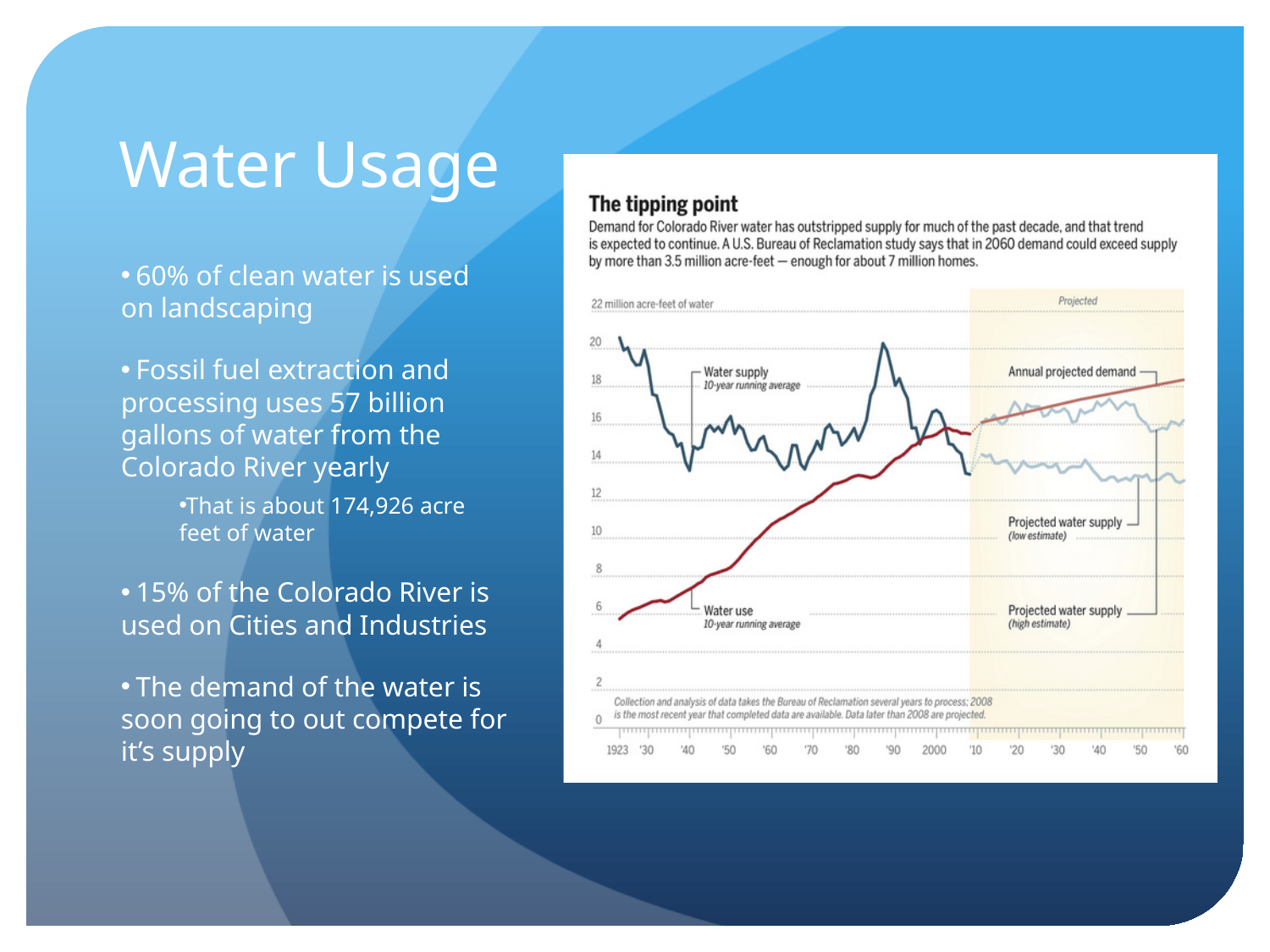
What is the title of the chart on the slide? The tipping point Does the Water use 10-year running average line rise or fall from 1923 to 2008? rise Is the Annual projected demand value in 2060 greater or less than 16 million acre-feet? greater In 2060, which is larger: the Annual projected demand or the Projected water supply (high estimate)? Annual projected demand What unit is the y axis of the chart measured in? million acre-feet of water What kind of chart is shown on the slide? line chart Is the Water use value in 1923 greater or less than 6 million acre-feet? less Is the Water use value around 2000 greater or less than 12 million acre-feet? greater What is the first year labelled on the x axis of the chart? 1923 Does the Annual projected demand line rise or fall from 2010 to 2060? rise